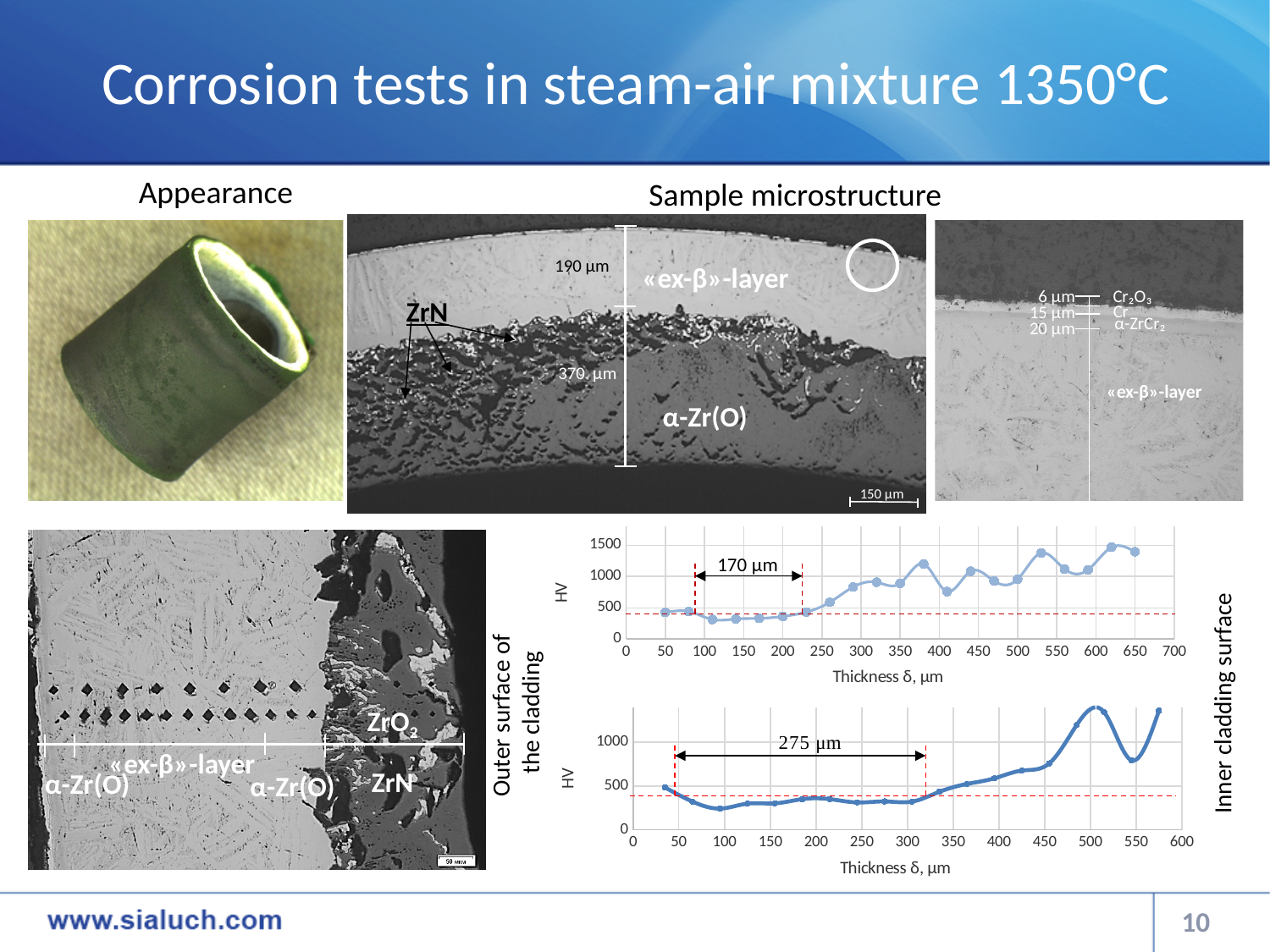
In the lower HV chart, is the HV value at a thickness of 100 μm greater or less than 500? less In the upper HV chart, which thickness has the higher HV value: 150 μm or 550 μm? 550 μm In the upper HV chart, is the HV value at a thickness of 100 μm greater or less than 500? less In the lower HV chart, what width is indicated by the arrow annotation between the dashed lines? 275 μm In the upper HV chart, what width is indicated by the arrow annotation between the dashed lines? 170 μm In the lower HV chart, is the HV value at a thickness of 500 μm greater or less than 1000? greater In the upper HV chart, what is the label of the y axis? HV In the upper HV chart, what is the label of the x axis? Thickness δ, μm What type of chart is the upper chart on the right side of the slide (HV vs Thickness)? line chart In the lower HV chart, does the HV value overall rise or fall as thickness increases from 100 μm to 500 μm? rise How many HV vs Thickness charts are shown on the slide? 2